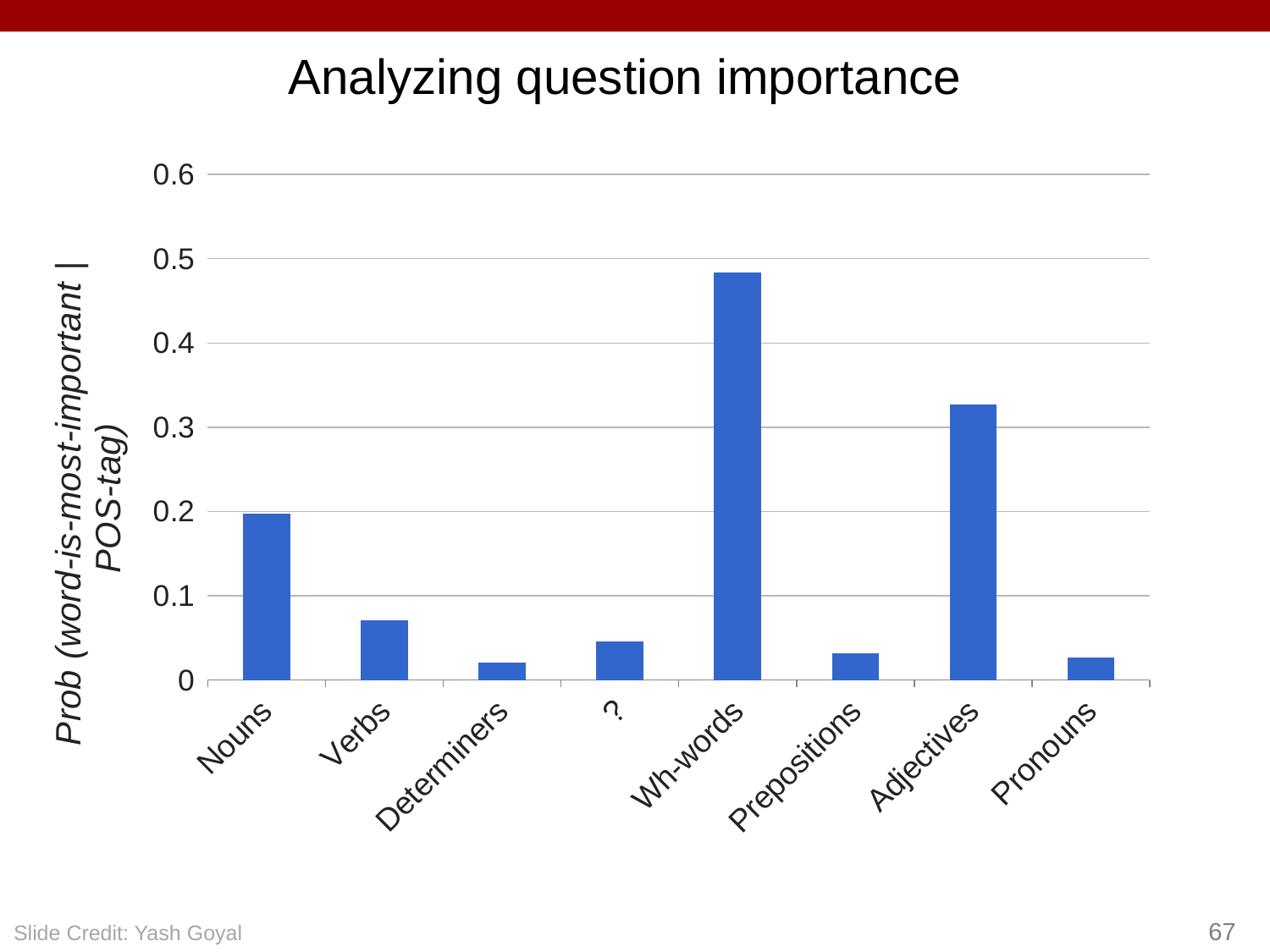
Which has a larger value, Nouns or Adjectives? Adjectives What is the label on the y axis of the chart? Prob (word-is-most-important | POS-tag) Which category has the highest value in the chart? Wh-words Is the value for Wh-words greater or less than 0.4? greater Is the value for Verbs greater or less than 0.1? less How many categories are shown on the x axis of the chart? 8 Is the value for Nouns greater or less than 0.1? greater What kind of chart is shown on the slide? bar chart What is the title of the slide's chart? Analyzing question importance Which has a larger value, Verbs or Prepositions? Verbs